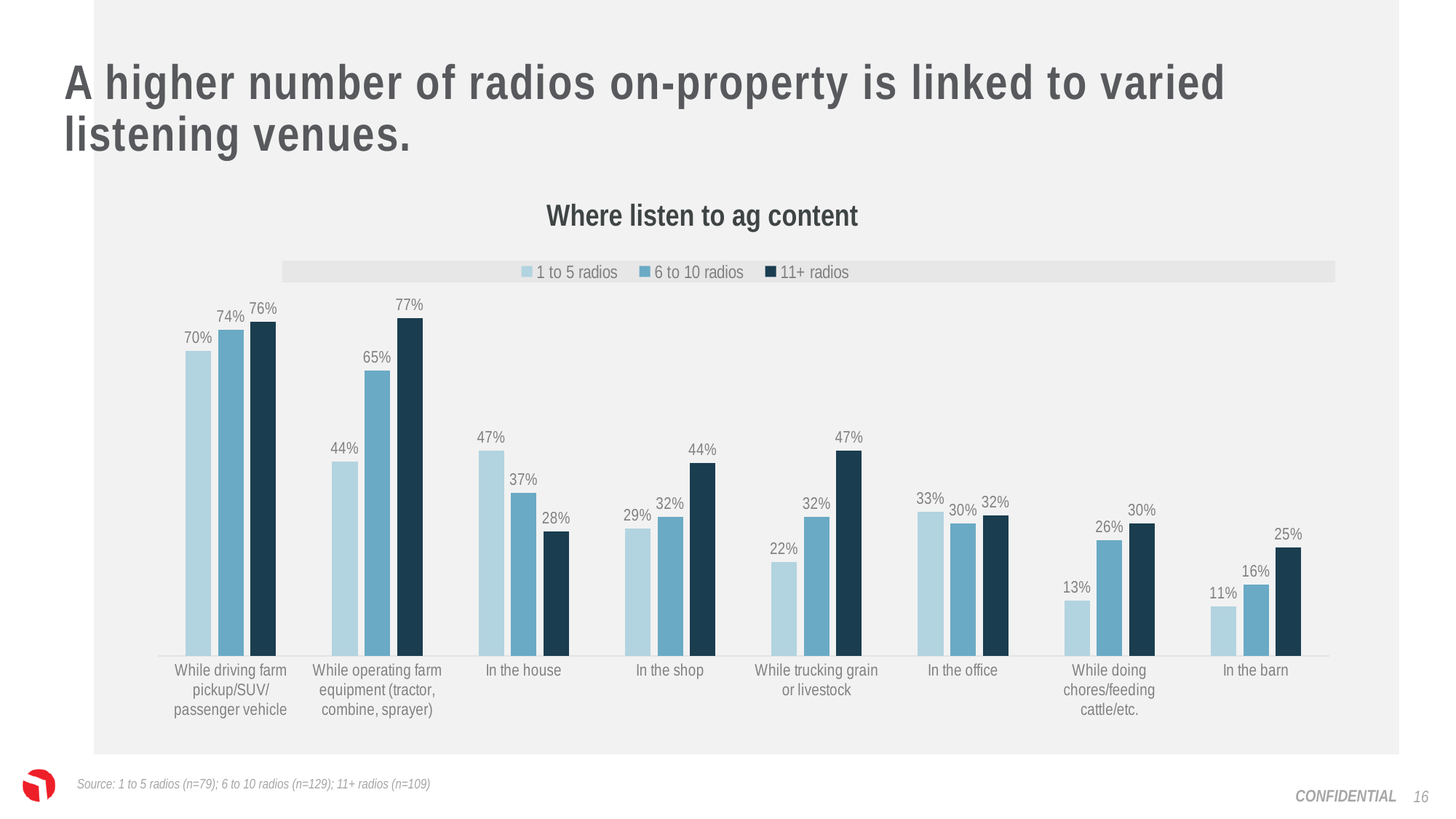
What is the title of the chart? Where listen to ag content What is the value for '11+ radios' in the 'In the shop' category? 44% Which category has the lowest value for the '1 to 5 radios' series? In the barn Which category has the highest value for the '11+ radios' series? While operating farm equipment (tractor, combine, sprayer) What is the difference between the '11+ radios' and '1 to 5 radios' values for 'While trucking grain or livestock'? 25% What is the value for '1 to 5 radios' in the 'In the barn' category? 11% What is the value for '6 to 10 radios' in the 'While operating farm equipment (tractor, combine, sprayer)' category? 65% What kind of chart is shown on the slide? Bar chart How many series does the legend list? 3 Which is larger in the 'In the house' category: the value for '1 to 5 radios' or for '11+ radios'? 1 to 5 radios How many categories are shown on the x axis? 8 What is the difference between the '6 to 10 radios' and '1 to 5 radios' values for 'While doing chores/feeding cattle/etc.'? 13%